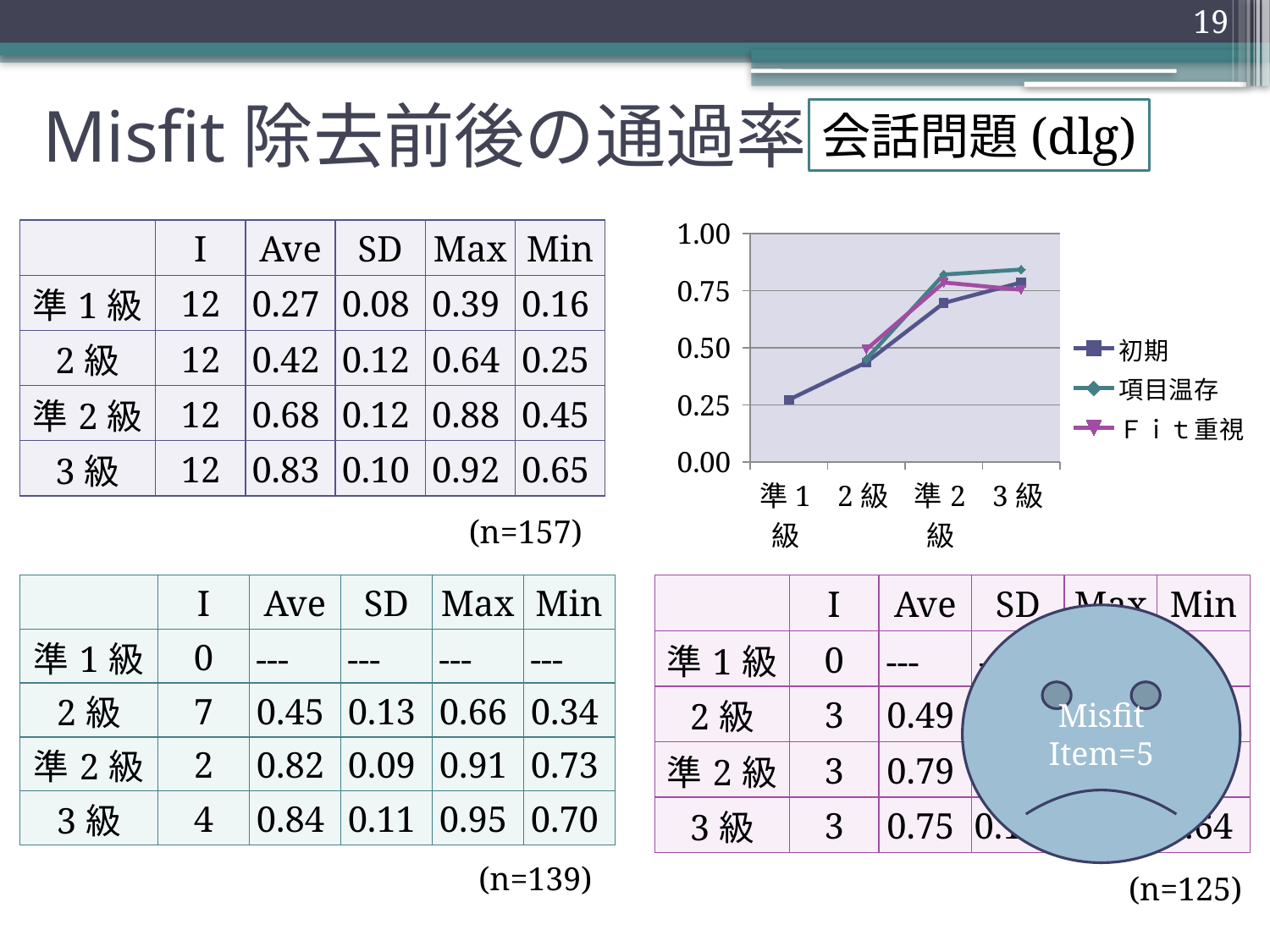
Which series is the only one with a data point at 準1級? 初期 How many series does the chart's legend list? 3 For the 初期 series, which category has the highest value? 3級 At 準2級, which series has the larger value, 初期 or 項目温存? 項目温存 Do the values of the 初期 series rise or fall from 準1級 to 3級? rise Is the value of the 項目温存 series at 準2級 greater or less than 0.75? greater Is the value of the 初期 series at 準1級 greater or less than 0.50? less What kind of chart is shown on the slide? line chart At 3級, which series has the larger value, 項目温存 or Fit重視? 項目温存 Which series are listed in the chart's legend? 初期, 項目温存, Fit重視 How many categories are shown on the x axis of the chart? 4 For the 初期 series, which category has the lowest value? 準1級